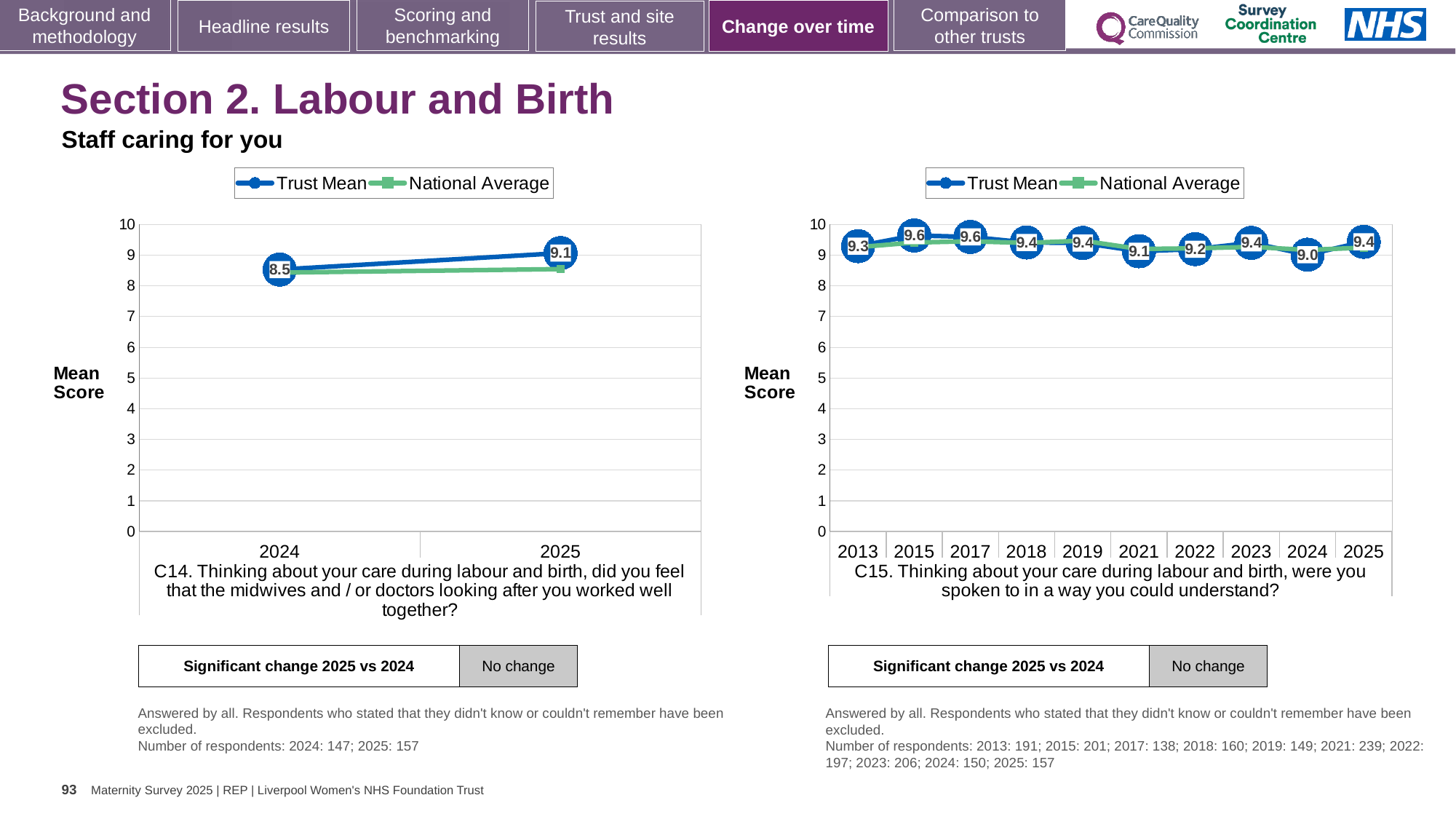
On the right chart (C15), what is the difference between the Trust Mean in 2025 and in 2024? 0.4 On the right chart (C15), how many years are shown on the x axis? 10 On the left chart (C14), by how much did the Trust Mean change from 2024 to 2025? 0.6 What type of chart is the right chart (C15)? line chart On the left chart (C14), what is the Trust Mean score for 2025? 9.1 On the left chart (C14), does the Trust Mean rise or fall from 2024 to 2025? rise On the right chart (C15), which year has the lowest Trust Mean score? 2024 On the right chart (C15), is the Trust Mean for 2015 larger or smaller than the Trust Mean for 2024? larger On the left chart (C14), how many series does the legend list? 2 On the right chart (C15), what is the Trust Mean score for 2024? 9.0 On the left chart (C14), what is the Trust Mean score for 2024? 8.5 On the right chart (C15), what is the Trust Mean score for 2021? 9.1